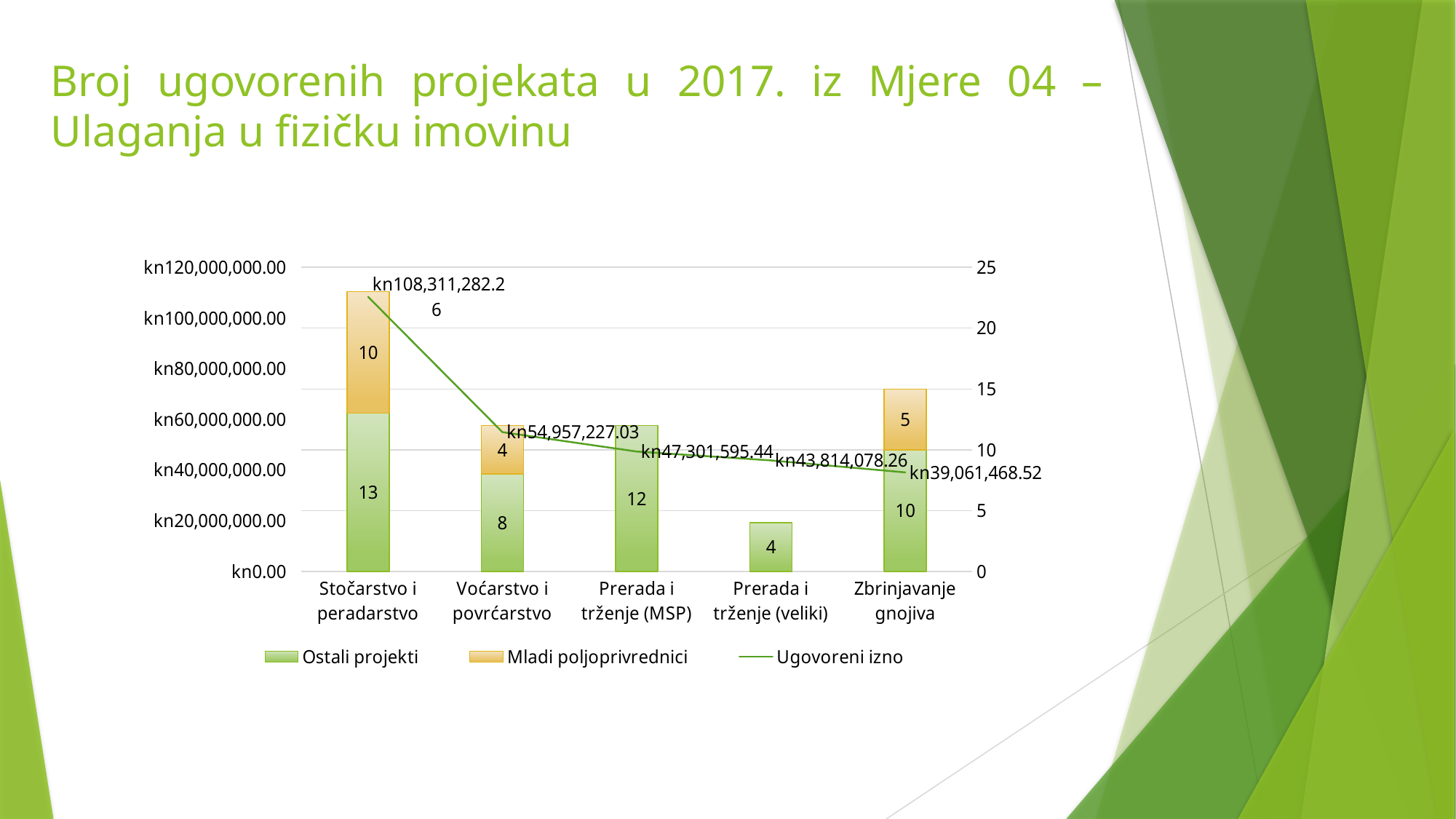
How many categories are shown on the x axis? 5 Which category has the highest Ugovoreni izno value? Stočarstvo i peradarstvo What is the value of Mladi poljoprivrednici for Zbrinjavanje gnojiva? 5 Which is larger, the Mladi poljoprivrednici value for Stočarstvo i peradarstvo or for Voćarstvo i povrćarstvo? Stočarstvo i peradarstvo Which category has the lowest Ostali projekti value? Prerada i trženje (veliki) What is the Ugovoreni izno value for Zbrinjavanje gnojiva? kn39,061,468.52 What is the total of the stacked bar for Stočarstvo i peradarstvo? 23 Does the Ugovoreni izno line rise or fall from left to right across the categories? fall How many series does the legend list? 3 What is the difference between the Ostali projekti values for Prerada i trženje (MSP) and Voćarstvo i povrćarstvo? 4 What is the Ugovoreni izno value for Voćarstvo i povrćarstvo? kn54,957,227.03 What is the value of Ostali projekti for Stočarstvo i peradarstvo? 13